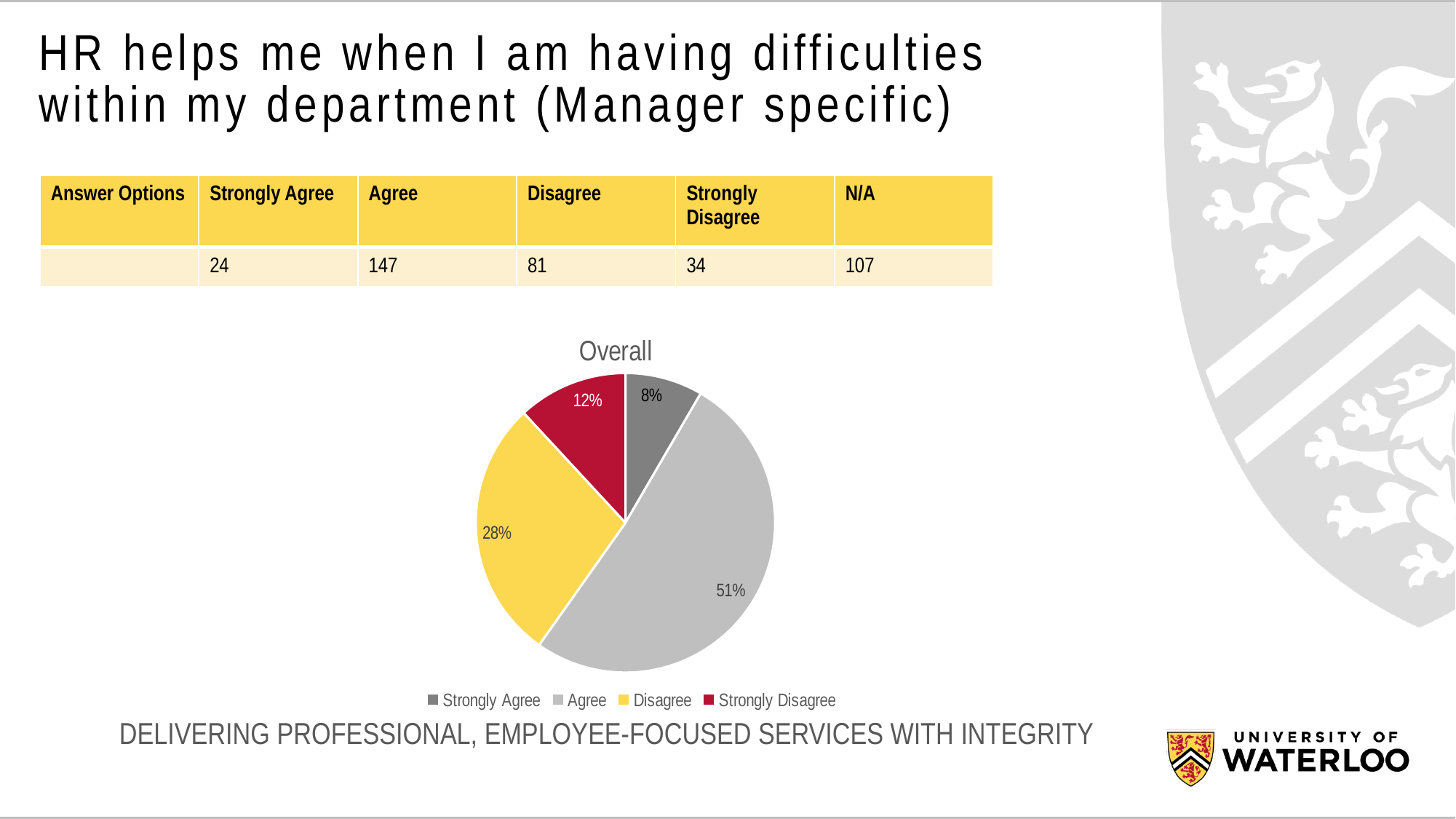
What type of chart is shown on the slide? pie chart What percentage of the pie does the Agree slice represent? 51% What is the title of the chart? Overall Which colour is used for the Strongly Disagree slice? red Which category has the smallest slice of the pie? Strongly Agree What is the difference in percentage points between the Agree and Disagree slices? 23 What percentage of the pie does the Disagree slice represent? 28% How many slices does the pie chart have? 4 What percentage of the pie does the Strongly Disagree slice represent? 12% Which slice is larger, Disagree or Strongly Disagree? Disagree Which category has the largest slice of the pie? Agree What percentage of the pie does the Strongly Agree slice represent? 8%